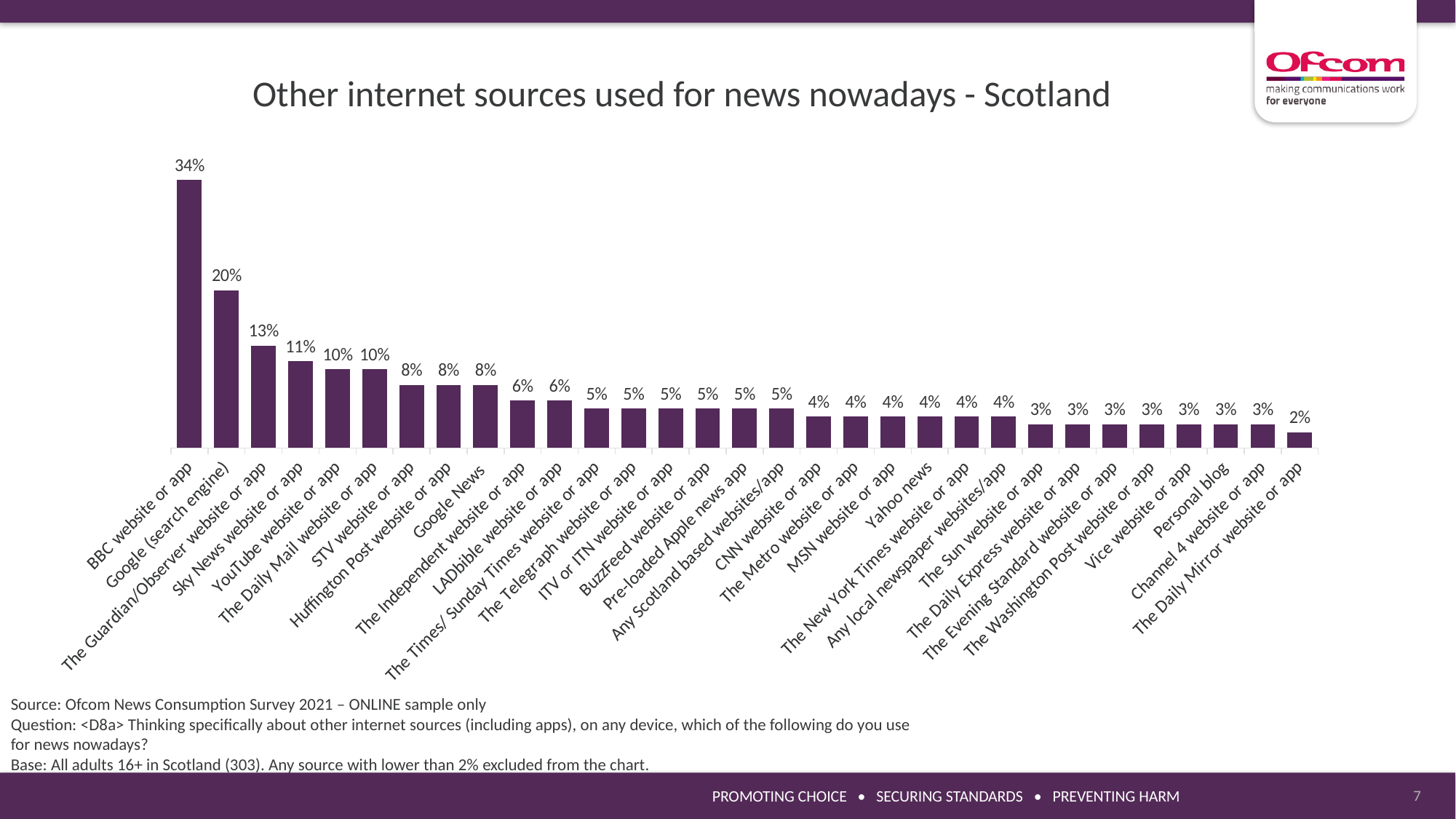
Which source has the lowest value? The Daily Mirror website or app What is the value for Sky News website or app? 11% Which is larger, the value for The Guardian/Observer website or app or the value for YouTube website or app? The Guardian/Observer website or app What is the value for Google News? 8% How many sources are shown in the chart? 31 Which source has the highest value? BBC website or app What is the difference between the values for BBC website or app and Google (search engine)? 14% What is the value for Google (search engine)? 20% What is the value for BBC website or app? 34% What is the value for Yahoo news? 4% What kind of chart is shown on the slide? Bar chart What is the title of the chart? Other internet sources used for news nowadays - Scotland